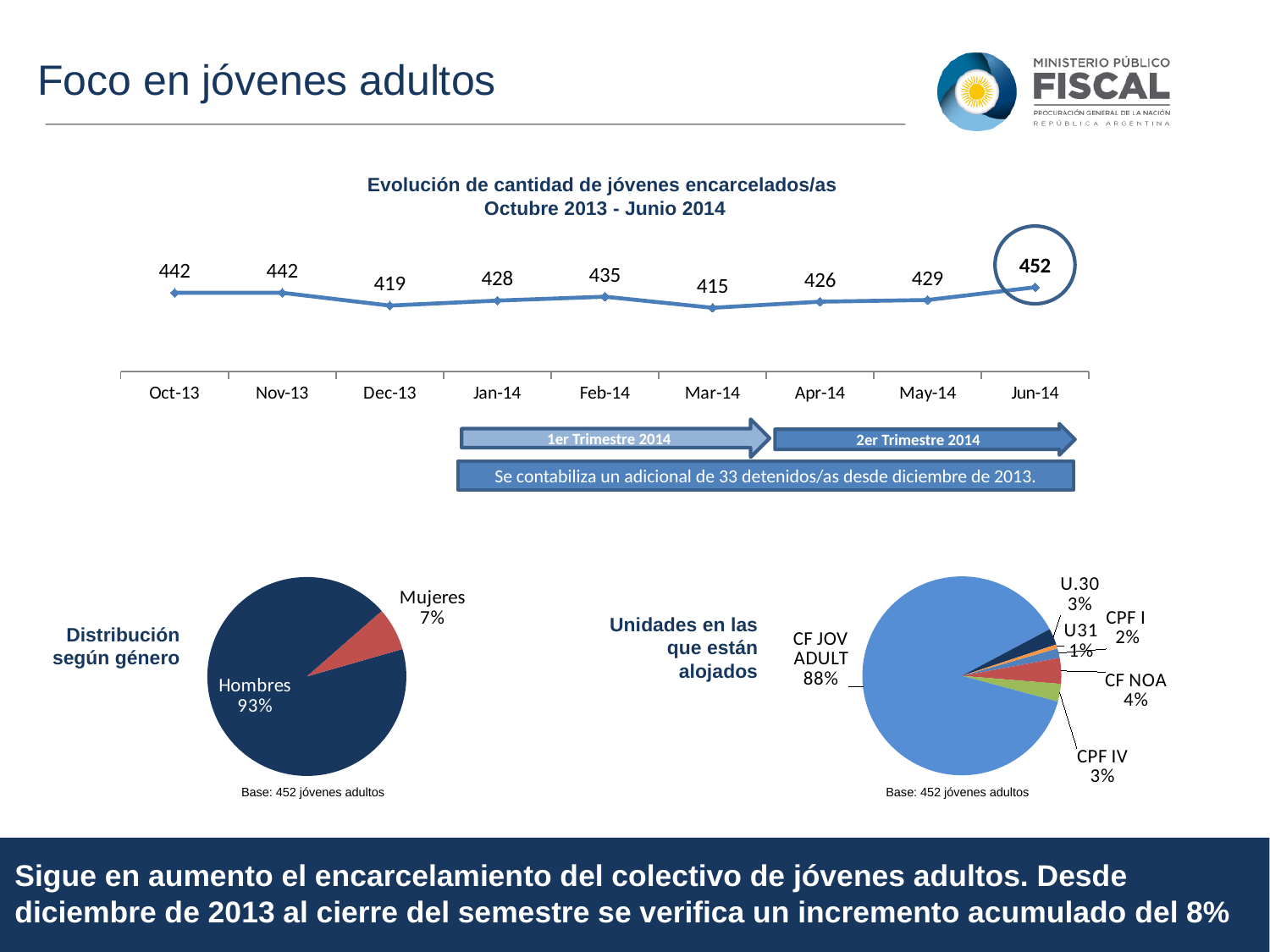
In the chart 'Evolución de cantidad de jóvenes encarcelados/as', what is the value for Dec-13? 419 How many data points are plotted in the chart 'Evolución de cantidad de jóvenes encarcelados/as'? 9 In the chart 'Evolución de cantidad de jóvenes encarcelados/as', which month has the lowest value? Mar-14 In the chart 'Evolución de cantidad de jóvenes encarcelados/as', what is the value for Jun-14? 452 In the pie chart 'Distribución según género', what share is Hombres? 93% How many slices does the pie chart 'Unidades en las que están alojados' have? 6 In the pie chart 'Unidades en las que están alojados', what share is CF NOA? 4% In the chart 'Evolución de cantidad de jóvenes encarcelados/as', which month has the highest value? Jun-14 In the chart 'Evolución de cantidad de jóvenes encarcelados/as', which is larger, the value for Feb-14 or the value for Mar-14? Feb-14 In the pie chart 'Distribución según género', what share is Mujeres? 7% In the chart 'Evolución de cantidad de jóvenes encarcelados/as', what is the difference between the Jun-14 value and the Dec-13 value? 33 What kind of chart is 'Evolución de cantidad de jóvenes encarcelados/as'? Line chart